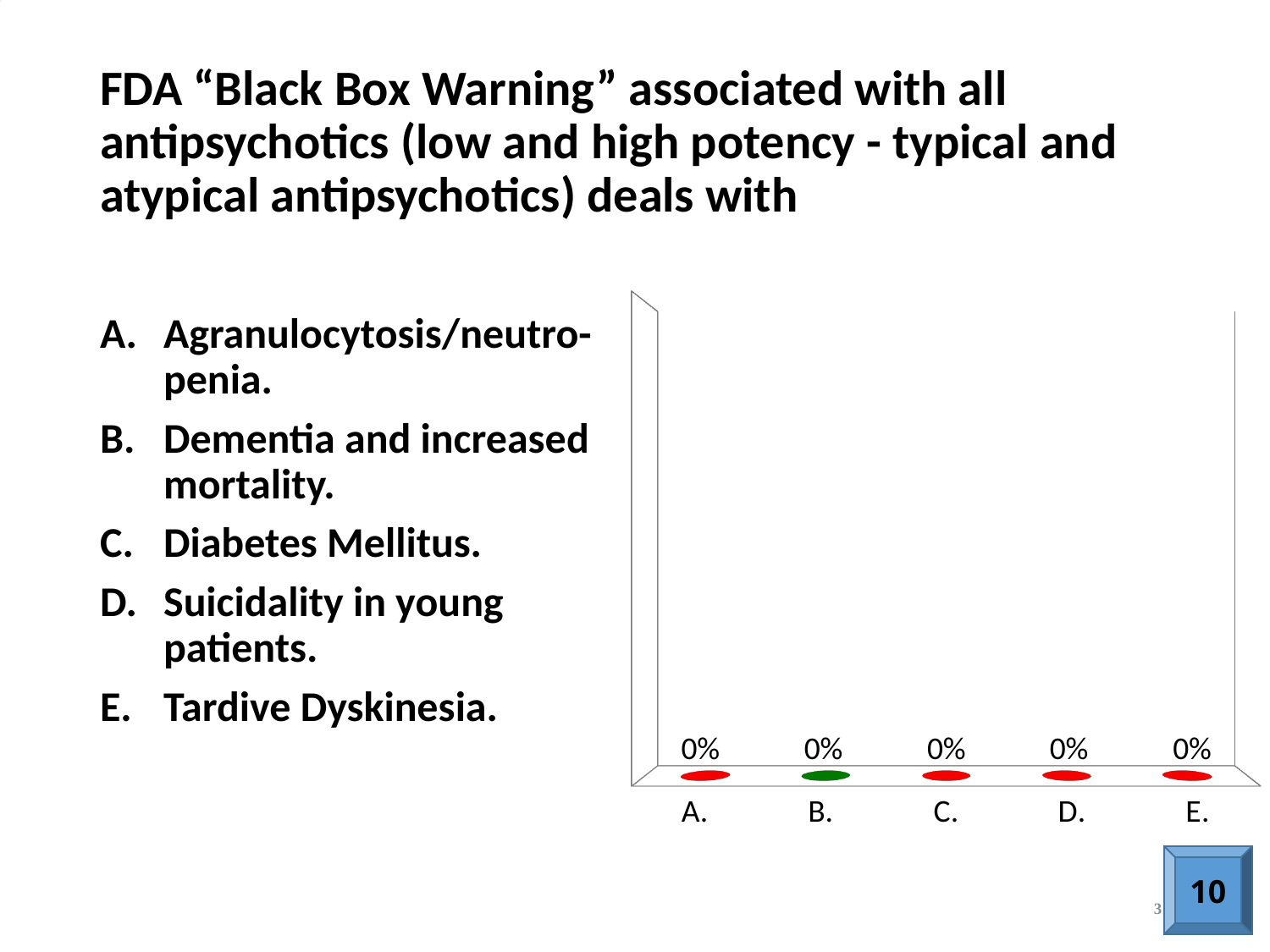
What is the difference between the values for category A. and category E. in the chart? 0% Which category's bar is coloured green rather than red in the chart? B. What is the value shown for category D. in the chart? 0% What kind of chart is shown on the slide? bar chart What is the value shown for category E. in the chart? 0% What is the total of all five values shown in the chart? 0% What is the value shown for category B. in the chart? 0% What is the value shown for category A. in the chart? 0% How many categories are shown on the x axis of the chart? 5 What is the value shown for category C. in the chart? 0% What are the category labels along the x axis of the chart, in order? A., B., C., D., E.